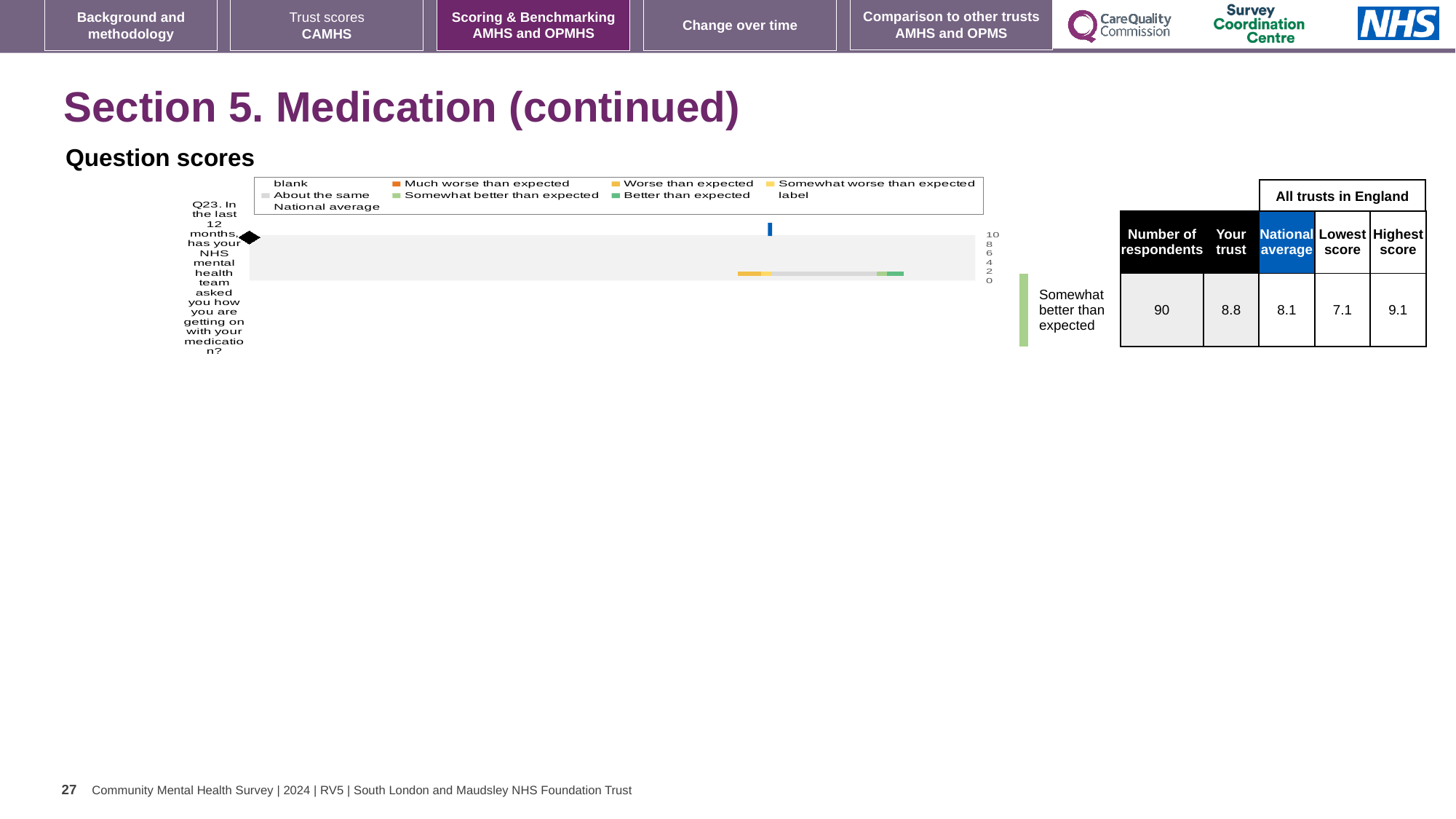
How many respondents answered Q23? 90 What is the 'Your trust' score for Q23 shown next to the chart? 8.8 What benchmark category is the trust's Q23 score assigned to? Somewhat better than expected What is the highest score among all trusts in England for Q23? 9.1 What is the National average score for Q23 shown next to the chart? 8.1 What is the difference between the 'Your trust' score and the National average for Q23? 0.7 Which legend entry in the Question scores chart is shown in orange? Much worse than expected How many questions (categories) are plotted in the Question scores chart? 1 What is the lowest score among all trusts in England for Q23? 7.1 Which is larger for Q23, the 'Your trust' score or the National average? Your trust What kind of chart is shown under 'Question scores'? bar chart What is the highest tick value shown on the chart's score axis? 10